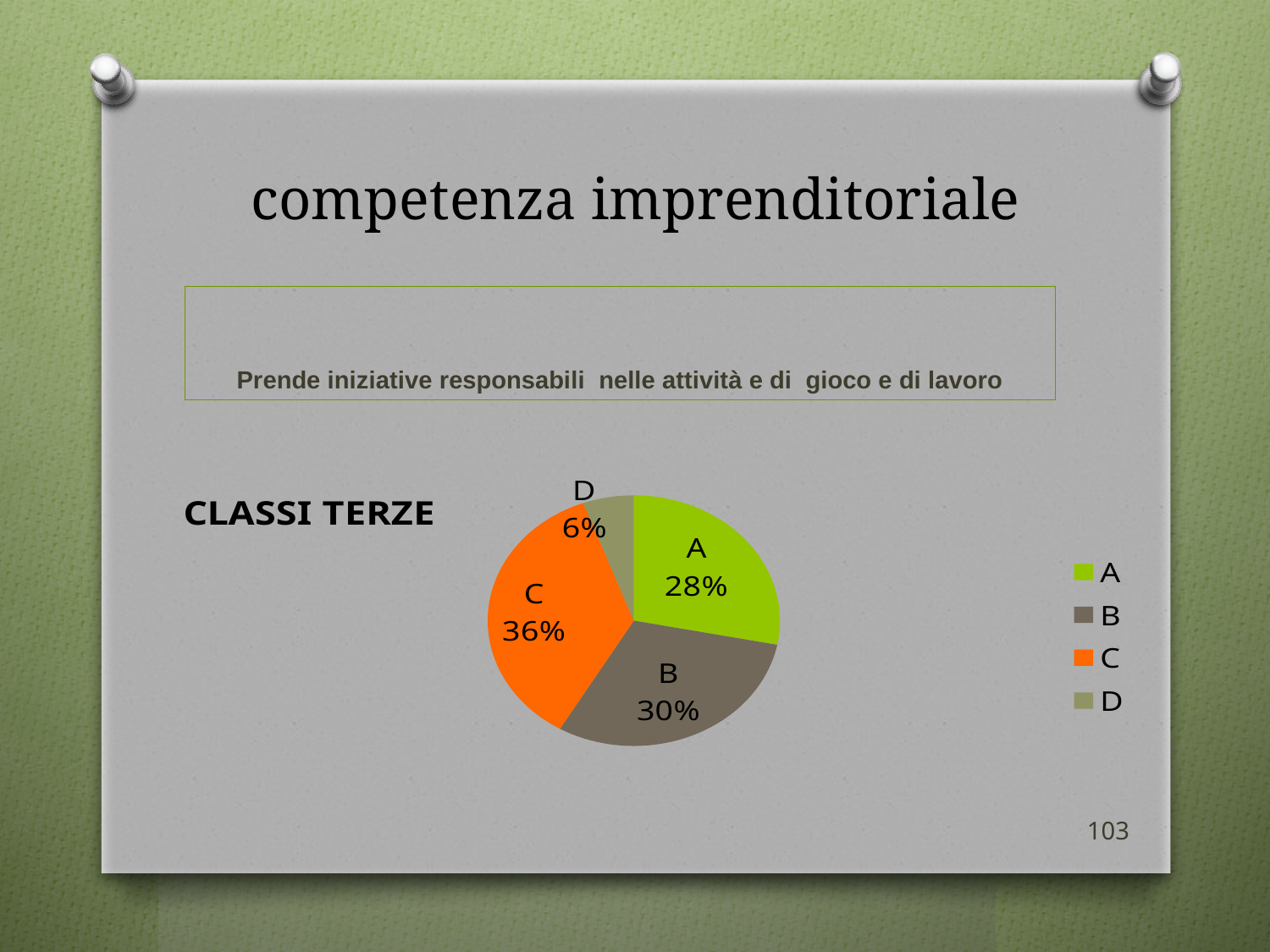
Which slice is larger, B or D? B What percentage of the pie chart does slice C represent? 36% What is the difference in percentage points between slice C and slice A? 8 What label appears to the left of the pie chart? CLASSI TERZE Which slice of the pie chart is the largest? C What percentage of the pie chart does slice D represent? 6% Which slice of the pie chart is the smallest? D How many entries does the legend list? 4 What kind of chart is shown on the slide? Pie chart How many slices does the pie chart have? 4 What colour is slice C in the pie chart? Orange What percentage of the pie chart does slice A represent? 28%